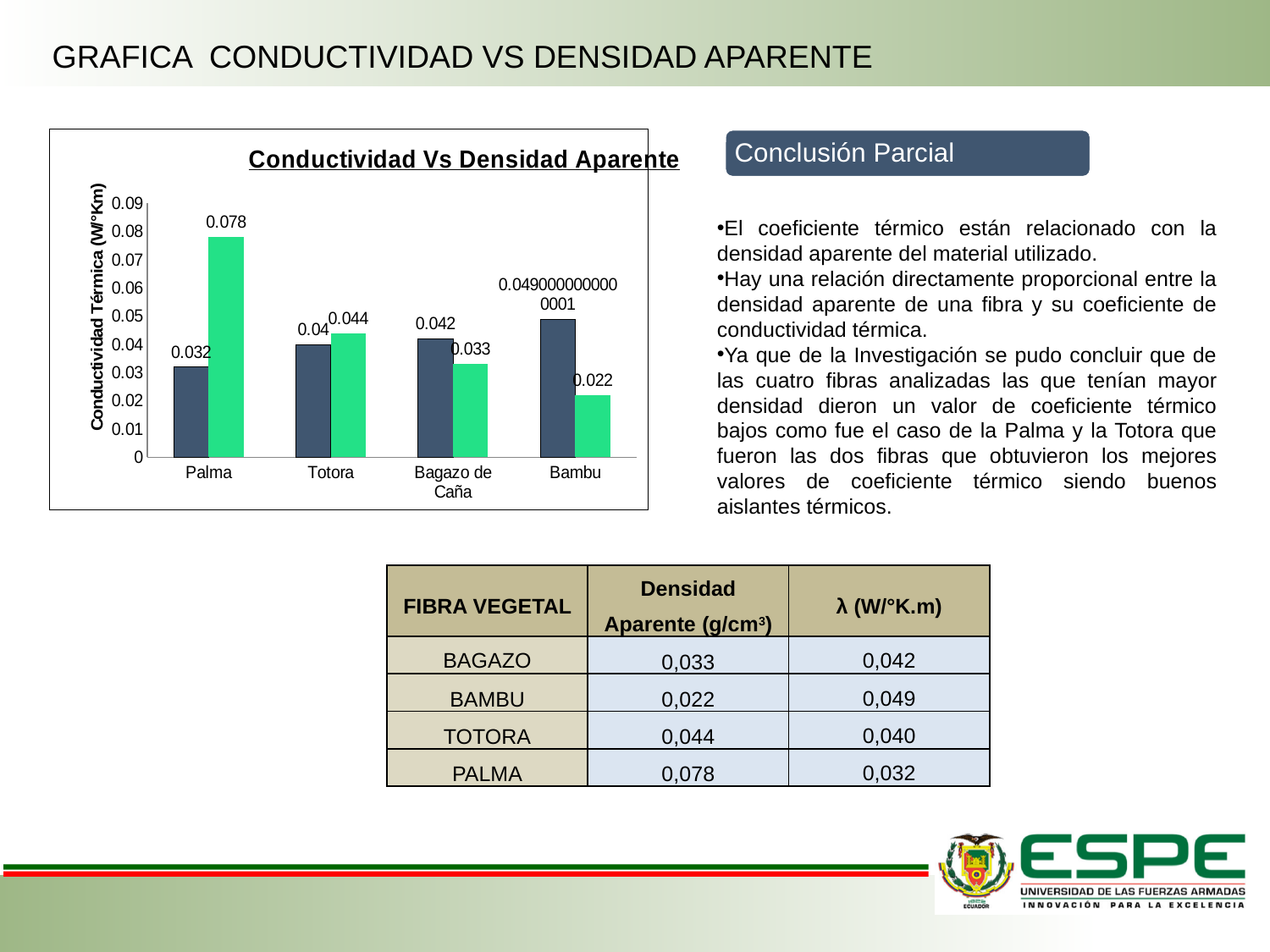
Which category has the lowest dark blue bar? Palma What is the value of the green bar for Palma? 0.078 What is the value of the green bar for Bambu? 0.022 What is the difference between the green bar and the dark blue bar for Palma? 0.046 What is the title of the y axis of the chart? Conductividad Térmica (W/°Km) What is the value of the dark blue bar for Totora? 0.04 Which category has the lowest green bar? Bambu What is the value of the dark blue bar for Bagazo de Caña? 0.042 What type of chart is shown on the slide? bar chart For Bagazo de Caña, which bar is larger, the dark blue bar or the green bar? the dark blue bar Which category has the highest green bar? Palma How many categories are shown on the x axis of the chart? 4